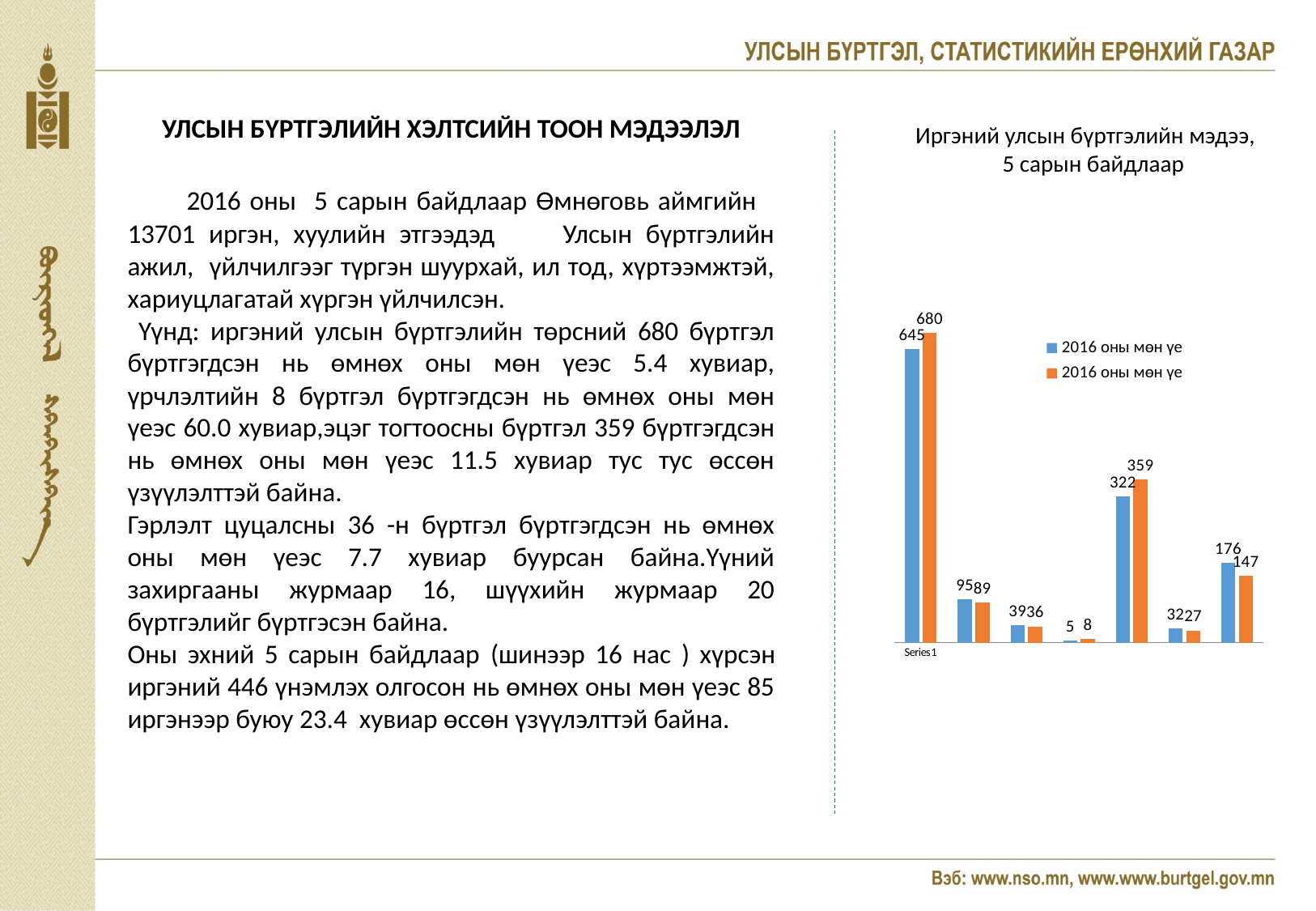
Which group of bars has the highest values in the chart? the first (leftmost) group What is the difference between the orange bar (680) and the blue bar (645) in the first group? 35 What is the value of the orange bar in the first (leftmost) group of bars? 680 What is the value of the blue bar in the last (rightmost) group of bars? 176 In the last (rightmost) group, which bar is larger, the blue one or the orange one? the blue one Which group of bars has the lowest values in the chart? the fourth group How many groups of bars are plotted in the chart? 7 What is the value of the blue bar in the first (leftmost) group of bars? 645 What is the value of the orange bar in the fifth group of bars? 359 What is the title of the chart on the right side of the slide? Иргэний улсын бүртгэлийн мэдээ, 5 сарын байдлаар How many series does the chart legend list? 2 What type of chart is shown on the slide? bar chart